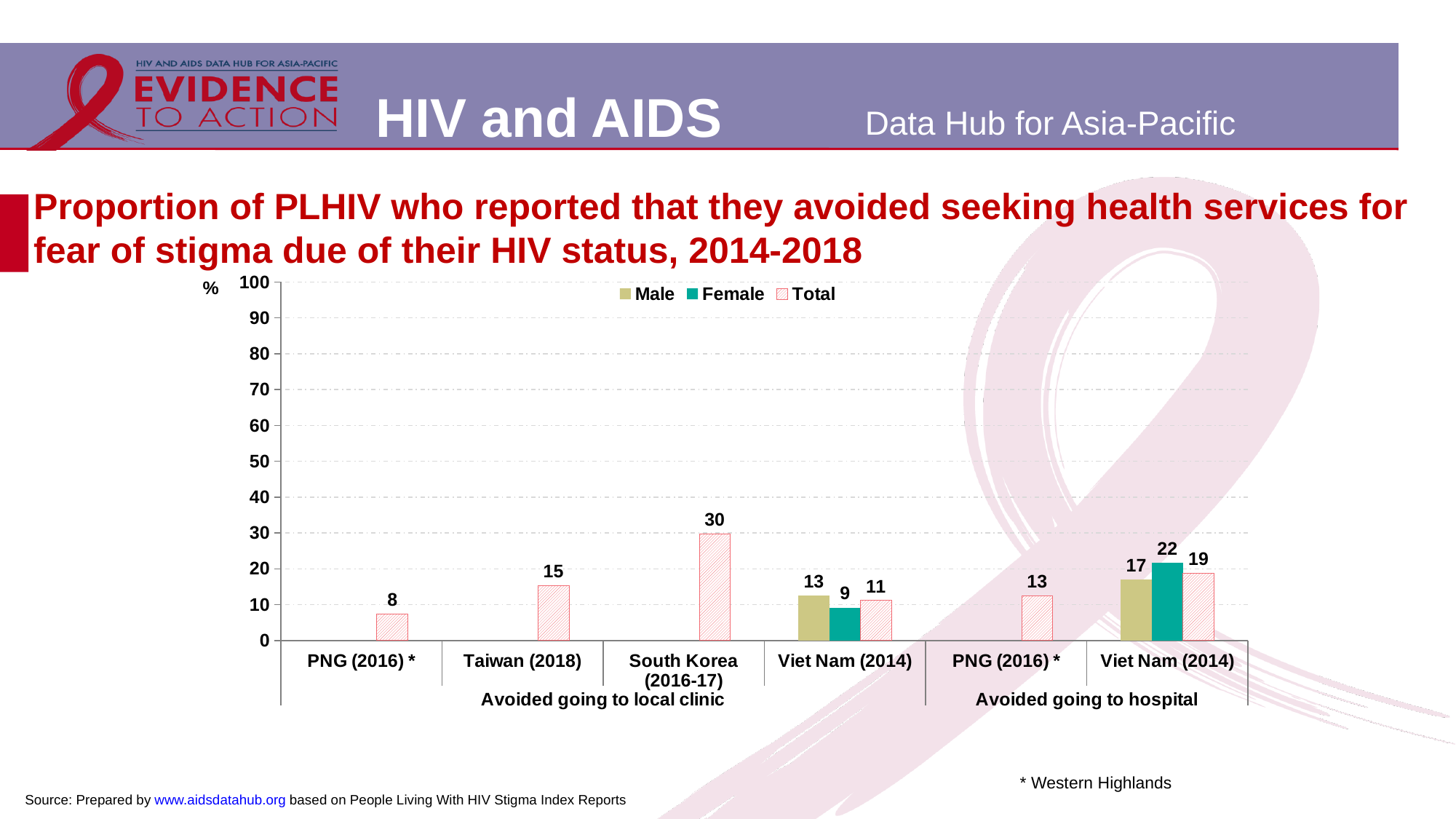
Is the Total value for South Korea (2016-17) greater or less than 20? greater Under 'Avoided going to local clinic', is the Total value for Taiwan (2018) or for PNG (2016) * larger? Taiwan (2018) What is the Total value for South Korea (2016-17) under 'Avoided going to local clinic'? 30 What is the Male value for Viet Nam (2014) under 'Avoided going to hospital'? 17 What is the unit shown on the y axis of the chart? % What is the Female value for Viet Nam (2014) under 'Avoided going to local clinic'? 9 What kind of chart is shown on the slide? Bar chart How many series does the legend list? 3 What is the difference between the Female and Male values for Viet Nam (2014) under 'Avoided going to hospital'? 5 Which country has the highest Total value under 'Avoided going to local clinic'? South Korea (2016-17) Which country has the lowest Total value under 'Avoided going to local clinic'? PNG (2016) * What is the Total value for PNG (2016) * under 'Avoided going to hospital'? 13